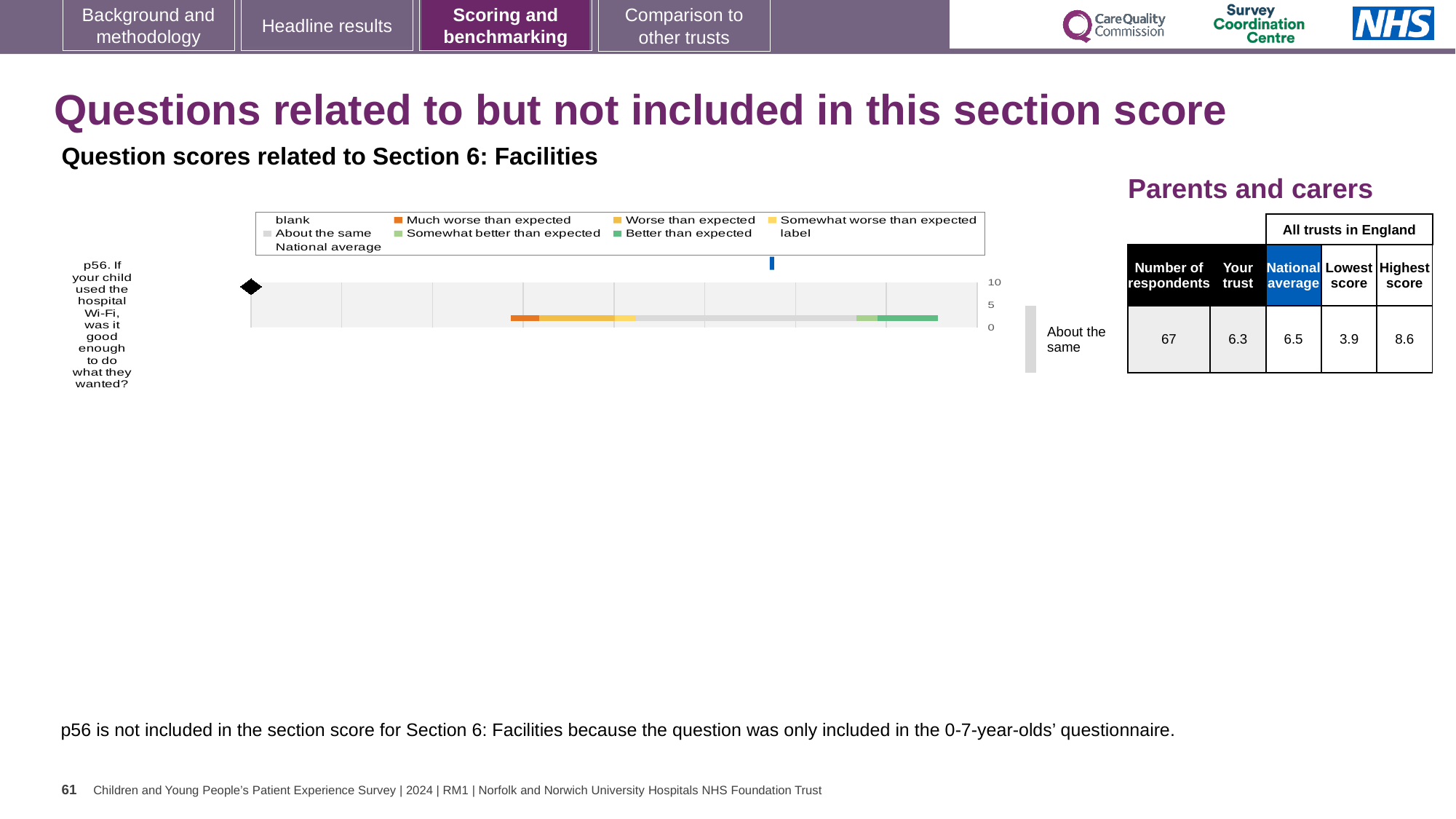
How many questions (categories) are plotted in the chart? 1 What is the highest score among all trusts in England for p56? 8.6 Which colour in the legend represents 'Much worse than expected'? orange What is the lowest score among all trusts in England for p56? 3.9 Which is larger for p56, the 'Your trust' score or the national average? national average What kind of chart is used to show the p56 question score? bar chart What is the 'Your trust' score for p56 shown in the table? 6.3 What is the difference between the highest and lowest trust scores for p56? 4.7 How many respondents answered p56? 67 What is the national average score for p56 shown in the table? 6.5 What rating band is the trust's p56 score placed in? About the same Which question is plotted in the chart? p56. If your child used the hospital Wi-Fi, was it good enough to do what they wanted?